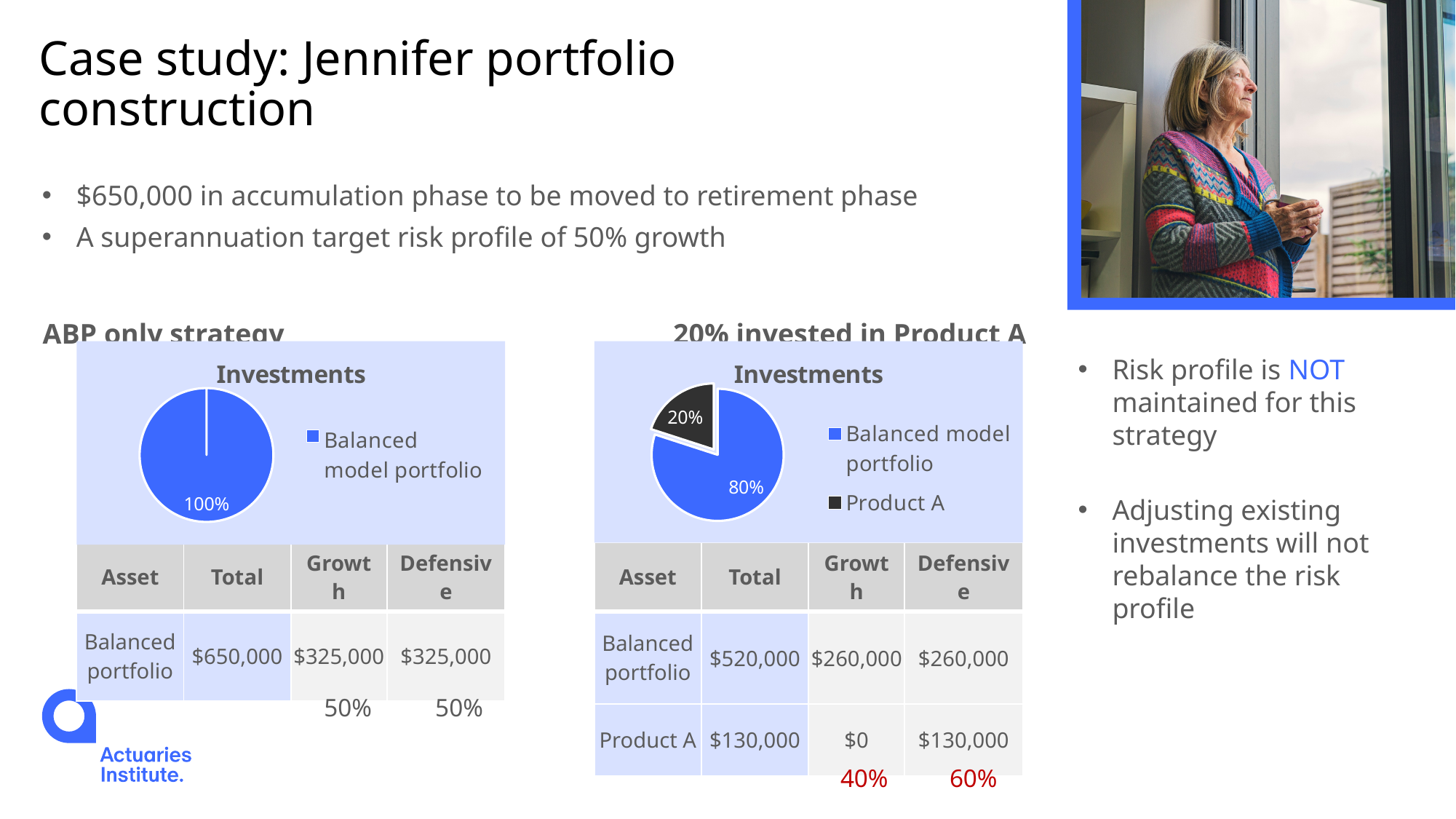
What is the title of the right-hand pie chart? Investments What kind of chart is the right-hand chart under "20% invested in Product A"? pie chart In the right-hand pie chart, what share does Product A have? 20% What kind of chart is the left-hand chart under "ABP only strategy"? pie chart In the right-hand pie chart, what share does Balanced model portfolio have? 80% In the right-hand pie chart, which is larger: Balanced model portfolio or Product A? Balanced model portfolio How many entries does the legend of the left-hand pie chart list? 1 In the right-hand pie chart, which slice is the smallest? Product A In the right-hand pie chart, which slice is the largest? Balanced model portfolio In the right-hand pie chart, what is the difference between the Balanced model portfolio share and the Product A share? 60% How many entries does the legend of the right-hand pie chart list? 2 In the left-hand pie chart, what share does Balanced model portfolio have? 100%